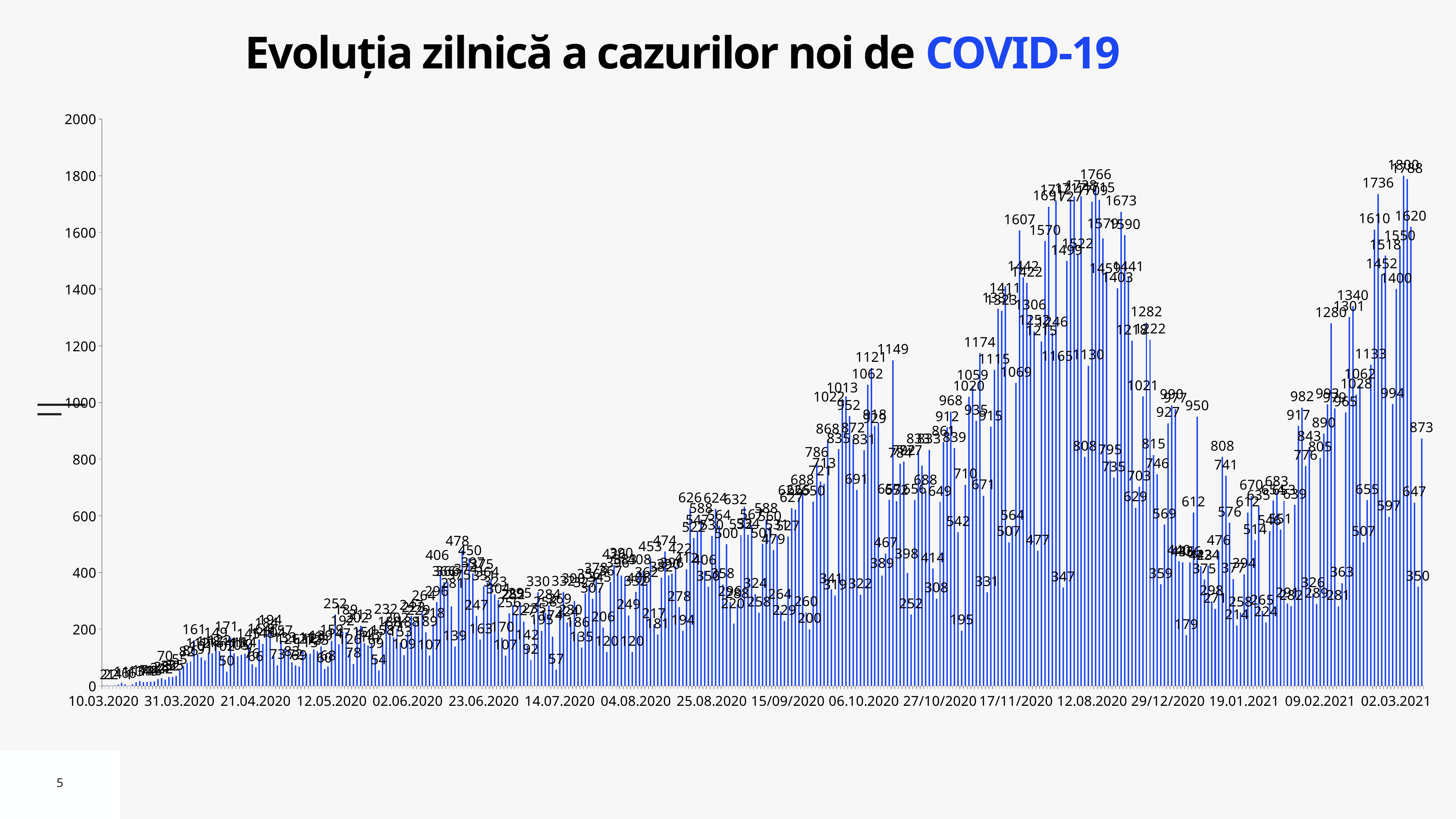
Overall, do the daily values rise or fall from 10.03.2020 to 02.03.2021? rise What is the difference between the peak value 1800 and the peak value 1766? 34 What is the highest value labelled in the wave around 17/11/2020 – 12.08.2020? 1766 Which is larger, the peak value 1766 in late 2020 or the peak value 1800 in March 2021? 1800 Is the highest bar around 23.06.2020 greater or less than 600? less What is the maximum value shown on the vertical axis? 2000 What is the first date label on the horizontal axis? 10.03.2020 What is the highest value labelled in the peak around 23.06.2020? 478 Is the highest bar on the chart greater or less than 2000? less What is the highest daily value labelled on the chart? 1800 What kind of chart is shown on the slide? bar chart What is the title of the chart? Evoluția zilnică a cazurilor noi de COVID-19